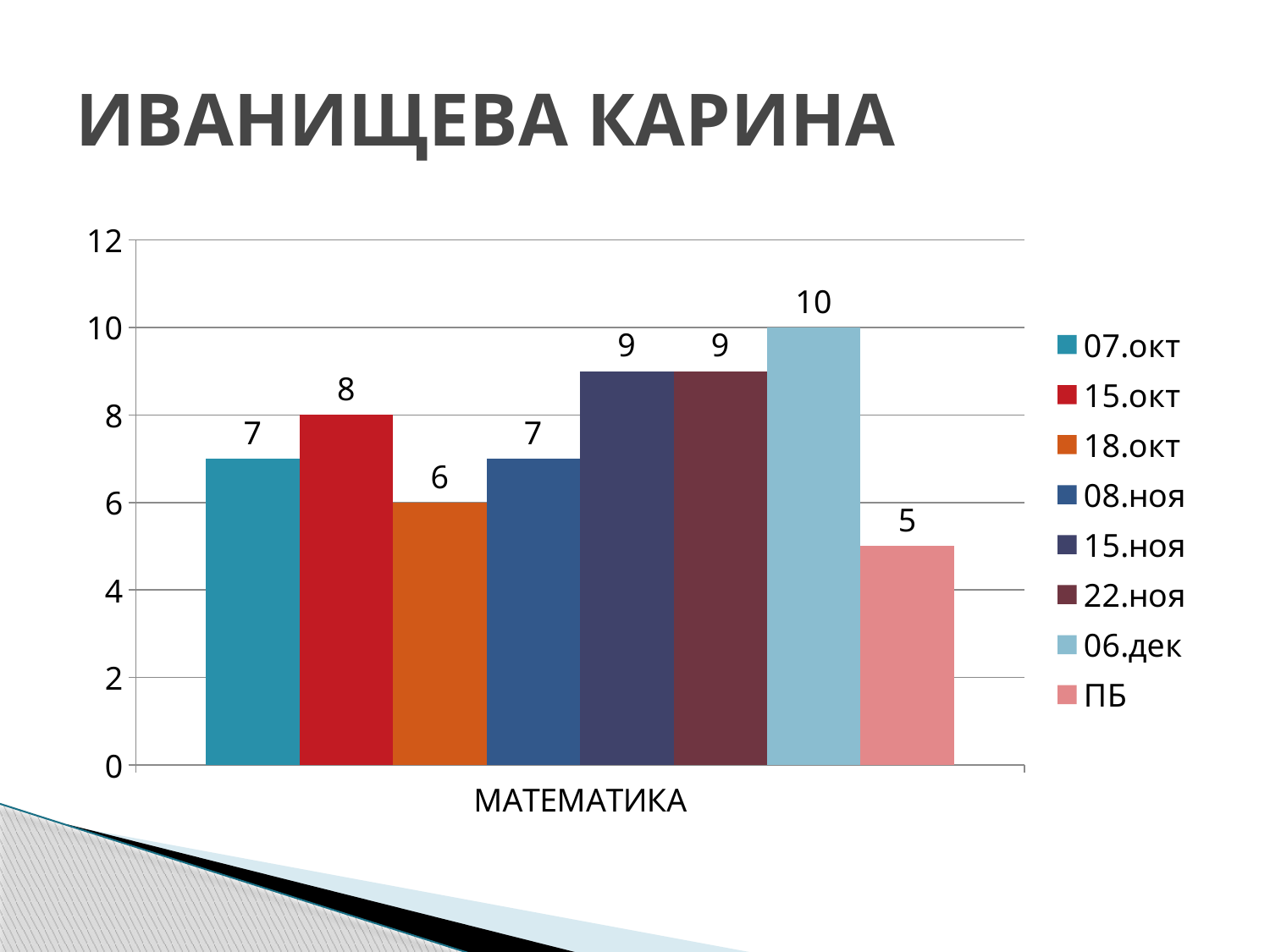
Which series has the lowest value in МАТЕМАТИКА? ПБ What is the difference between the values for 15.окт and 18.окт? 2 Which is larger, the value for 15.окт or the value for 08.ноя? 15.окт Which series has the highest value in МАТЕМАТИКА? 06.дек What kind of chart is shown on the slide? bar chart What is the category label shown on the x axis? МАТЕМАТИКА What is the value for 07.окт in МАТЕМАТИКА? 7 How many series does the legend list? 8 What is the value for 18.окт in МАТЕМАТИКА? 6 What is the difference between the values for 06.дек and ПБ? 5 What is the value for ПБ in МАТЕМАТИКА? 5 What is the value for 06.дек in МАТЕМАТИКА? 10